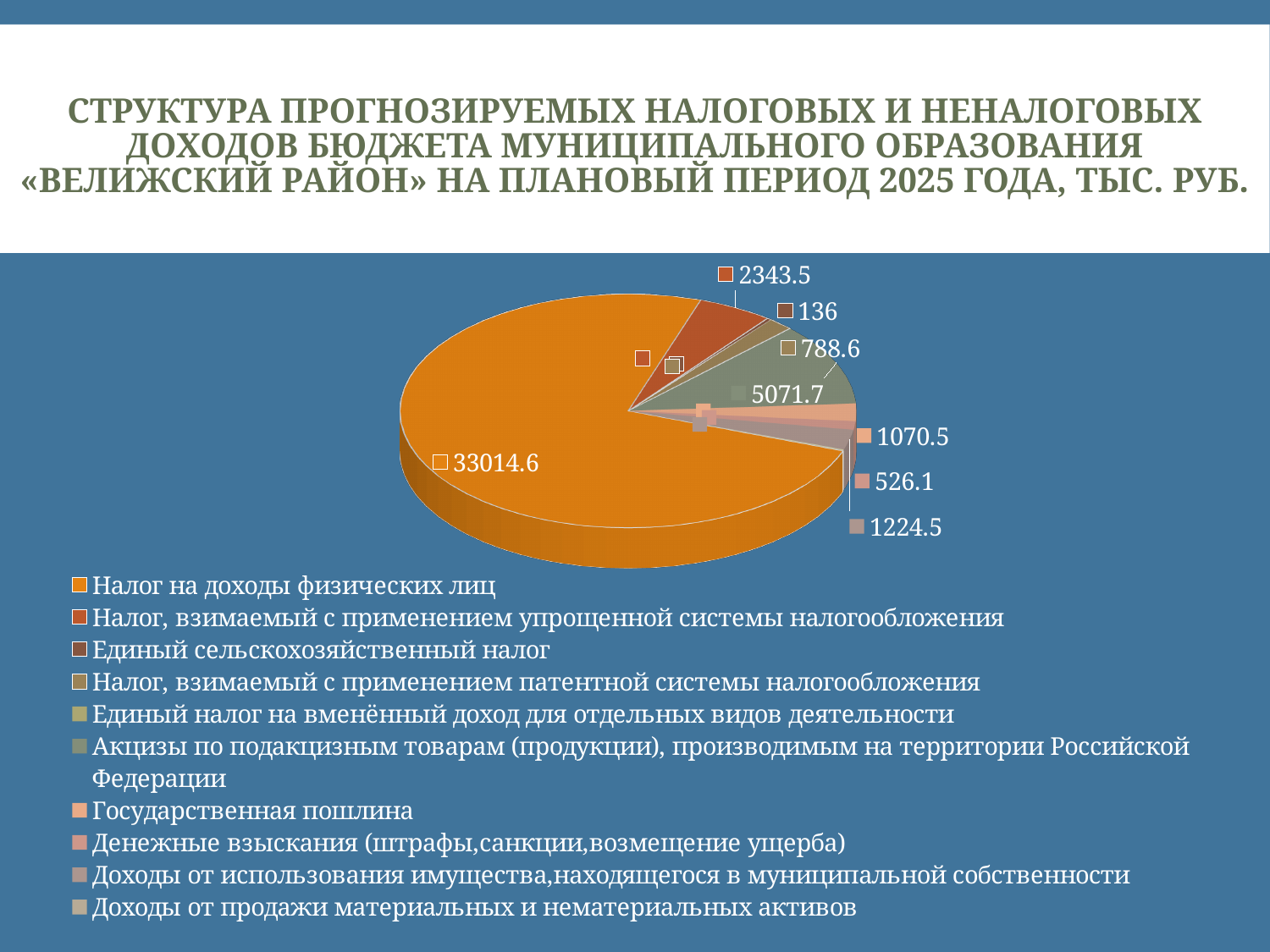
Which category has the largest slice of the pie? Налог на доходы физических лиц Which is larger, the slice labelled 2343.5 or the slice labelled 1224.5? 2343.5 What is the value of the largest slice of the pie? 33014.6 What is the value shown for Налог на доходы физических лиц? 33014.6 Which is larger, the slice labelled 1070.5 or the slice labelled 526.1? 1070.5 How many entries does the legend list? 10 Which year does the chart title say the forecast is for? 2025 What is the difference between the slice labelled 5071.7 and the slice labelled 788.6? 4283.1 What kind of chart is shown on the slide? pie chart What unit of measurement is stated in the chart title? тыс. руб. What is the difference between the slice labelled 1224.5 and the slice labelled 526.1? 698.4